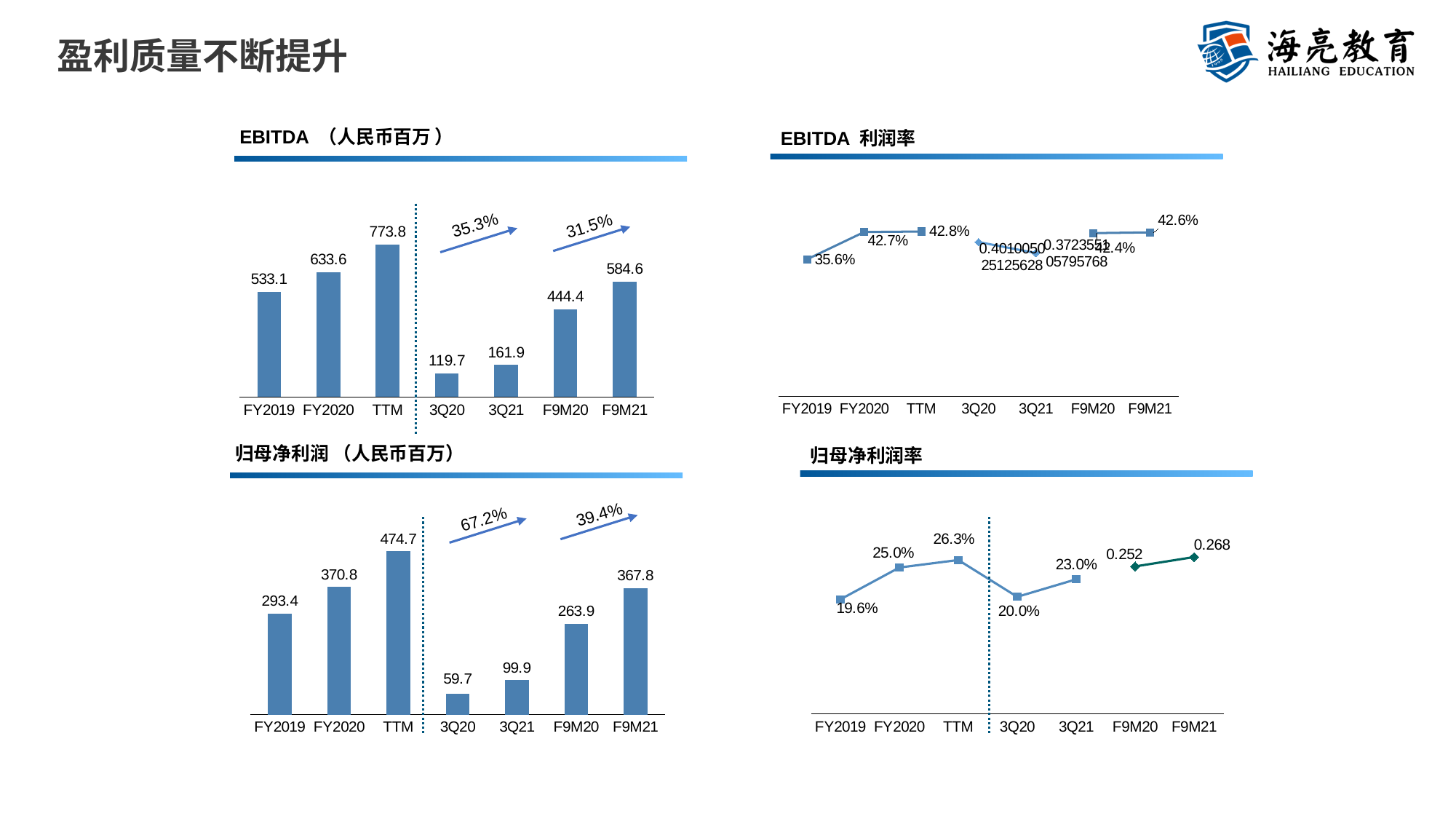
In the 归母净利润率 chart, what is the value for TTM? 26.3% In the EBITDA (人民币百万) chart, what is the difference between F9M21 and F9M20? 140.2 In the 归母净利润 (人民币百万) chart, what is the value for 3Q21? 99.9 What kind of chart is the EBITDA (人民币百万) chart? Bar chart In the 归母净利润率 chart, do the values rise or fall from FY2019 to TTM? Rise In the 归母净利润 (人民币百万) chart, what is the difference between FY2020 and FY2019? 77.4 In the 归母净利润 (人民币百万) chart, which category has the highest value? TTM In the EBITDA (人民币百万) chart, what is the value for TTM? 773.8 In the EBITDA (人民币百万) chart, how many bars are plotted? 7 In the EBITDA (人民币百万) chart, which category has the lowest value? 3Q20 In the EBITDA 利润率 chart, what is the value for FY2019? 35.6% In the EBITDA 利润率 chart, which is larger, FY2020 or FY2019? FY2020